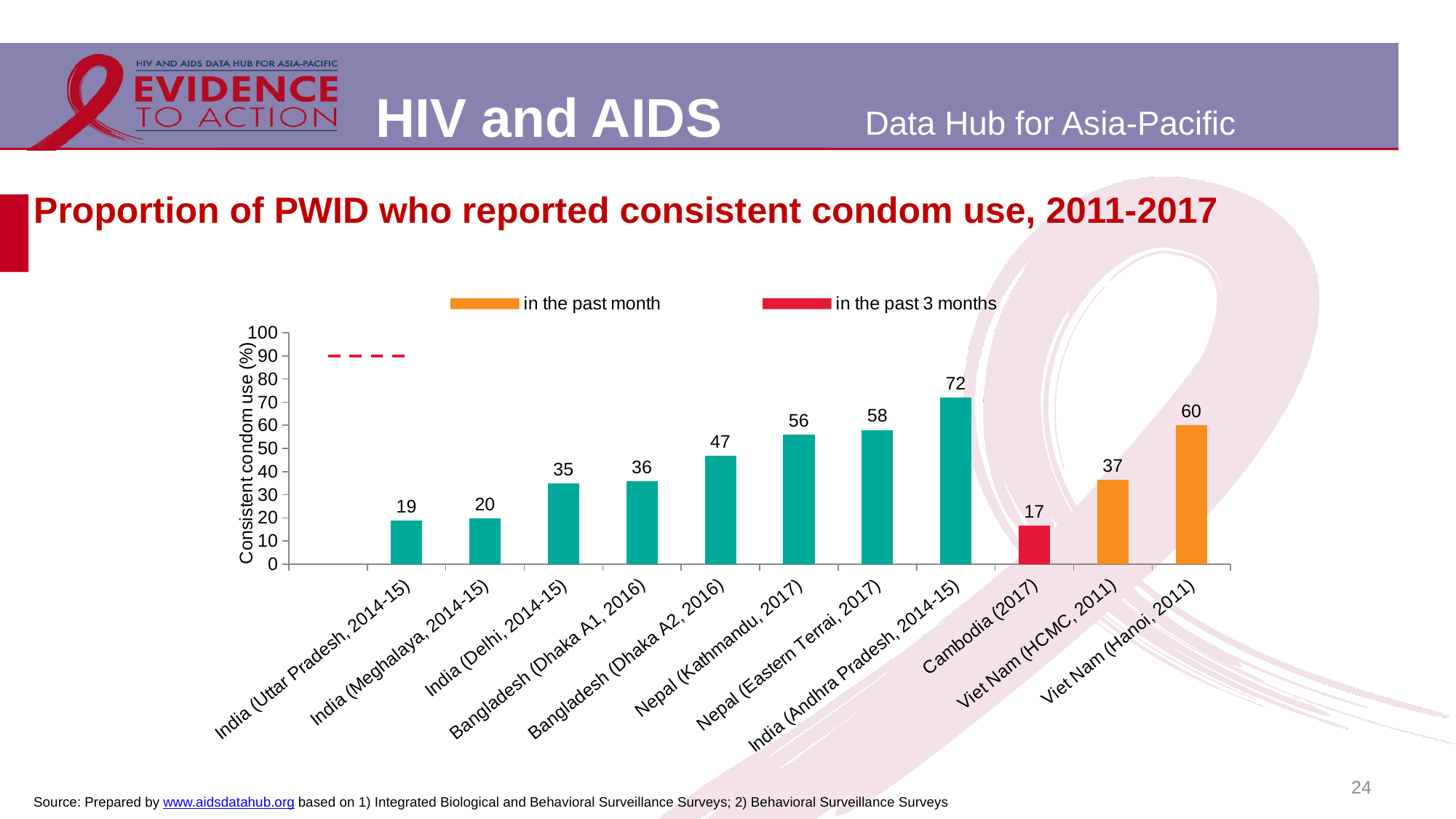
Which category has the highest value? India (Andhra Pradesh, 2014-15) Which category has the lowest value? Cambodia (2017) What is the label of the y axis? Consistent condom use (%) What kind of chart is shown on the slide? Bar chart What is the difference between the values for Viet Nam (Hanoi, 2011) and Viet Nam (HCMC, 2011)? 23 What is the value for Cambodia (2017)? 17 How many series does the legend list? 2 What is the value for Nepal (Kathmandu, 2017)? 56 How many categories are shown on the x axis? 11 What is the value for Viet Nam (Hanoi, 2011)? 60 Which is larger, the value for Bangladesh (Dhaka A2, 2016) or the value for India (Delhi, 2014-15)? Bangladesh (Dhaka A2, 2016) What is the value for India (Andhra Pradesh, 2014-15)? 72